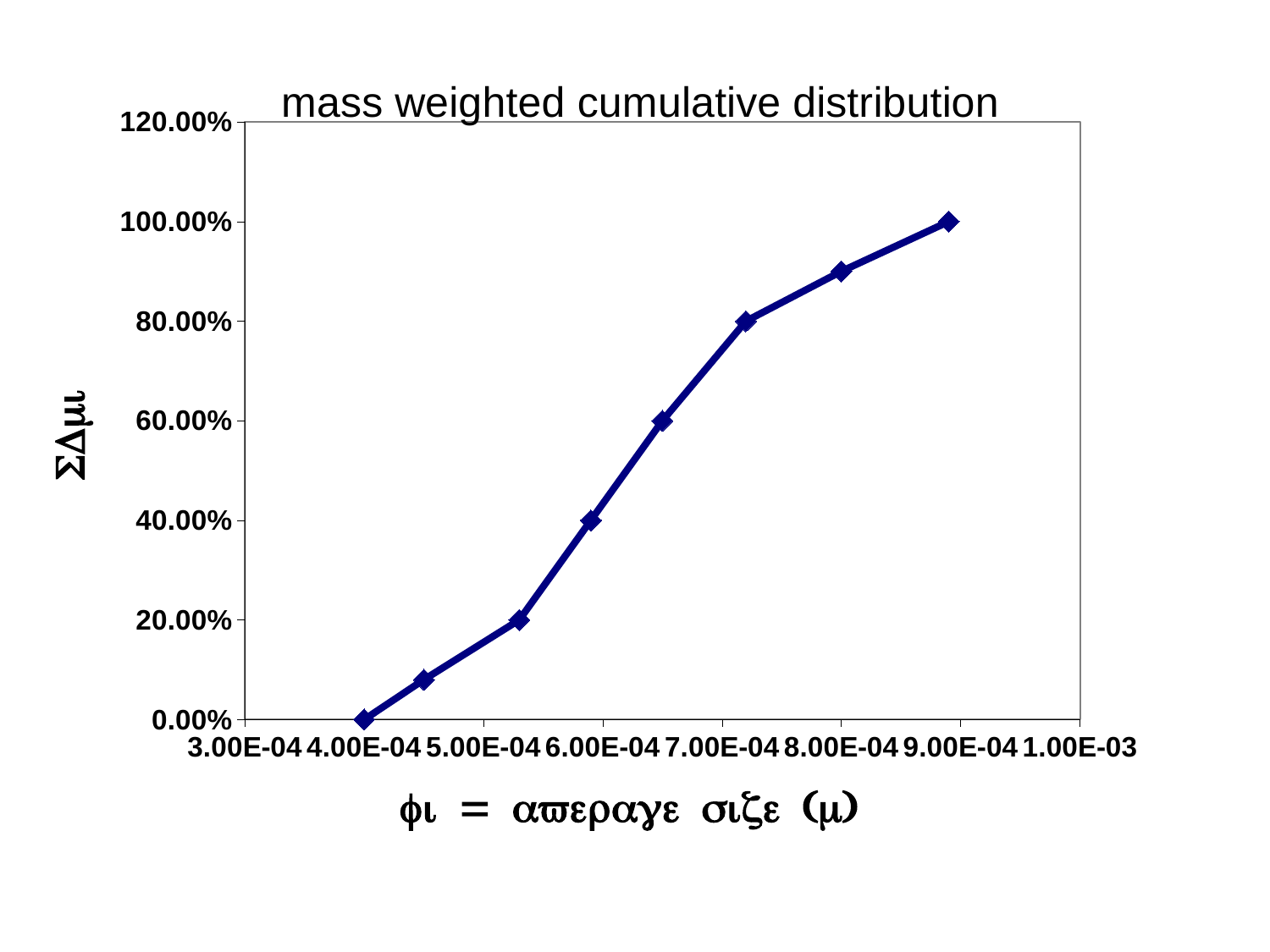
Is the value of the second data point from the right greater or less than 80.00%? greater What is the title of the chart? mass weighted cumulative distribution What kind of chart is shown on the slide? line chart What is the highest value reached by the line, at its rightmost point? 100.00% What is the maximum value shown on the y axis? 120.00% Which is larger, the value of the leftmost data point or the value of the rightmost data point? the rightmost data point Is the value of the second data point from the left greater or less than 20.00%? less What is the label on the y axis of the chart? ΣΔμι What is the lowest value on the line, at its leftmost point? 0.00% How many data points are plotted on the line? 8 Is the value of the fourth data point from the left greater or less than 60.00%? less Do the values rise or fall as the x axis increases? rise